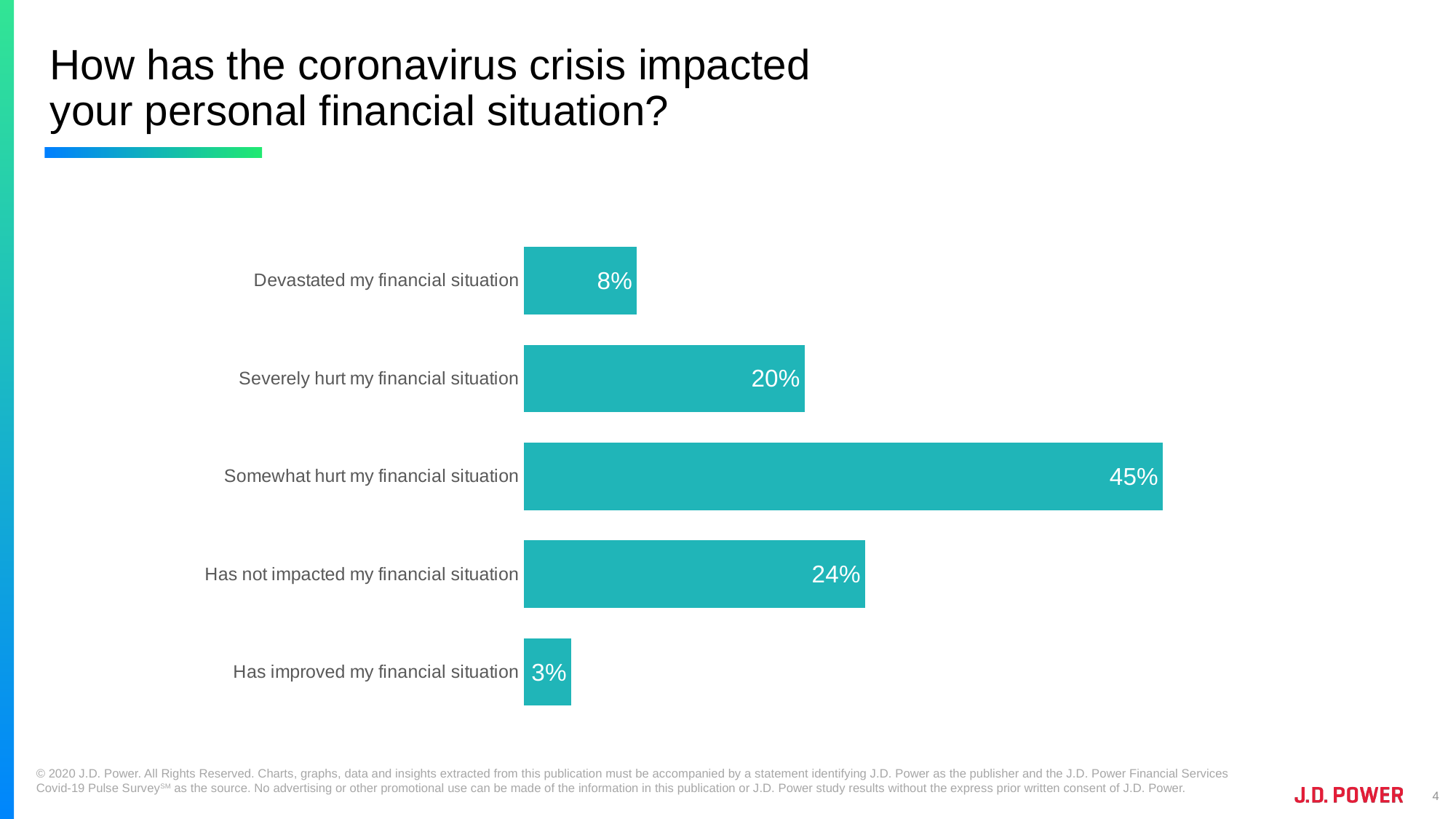
What kind of chart is shown on the slide? Bar chart What percentage of respondents said the crisis devastated their financial situation? 8% What is the difference between 'Severely hurt my financial situation' and 'Devastated my financial situation'? 12% Which is larger: 'Has not impacted my financial situation' or 'Severely hurt my financial situation'? Has not impacted my financial situation What question does the slide title ask? How has the coronavirus crisis impacted your personal financial situation? How many response categories are shown in the chart? 5 Which response category has the lowest value? Has improved my financial situation What is the difference between 'Somewhat hurt my financial situation' and 'Has not impacted my financial situation'? 21% What is the value for 'Severely hurt my financial situation'? 20% Which response category has the highest value? Somewhat hurt my financial situation What percentage said the crisis has improved their financial situation? 3% What is the value for 'Has not impacted my financial situation'? 24%